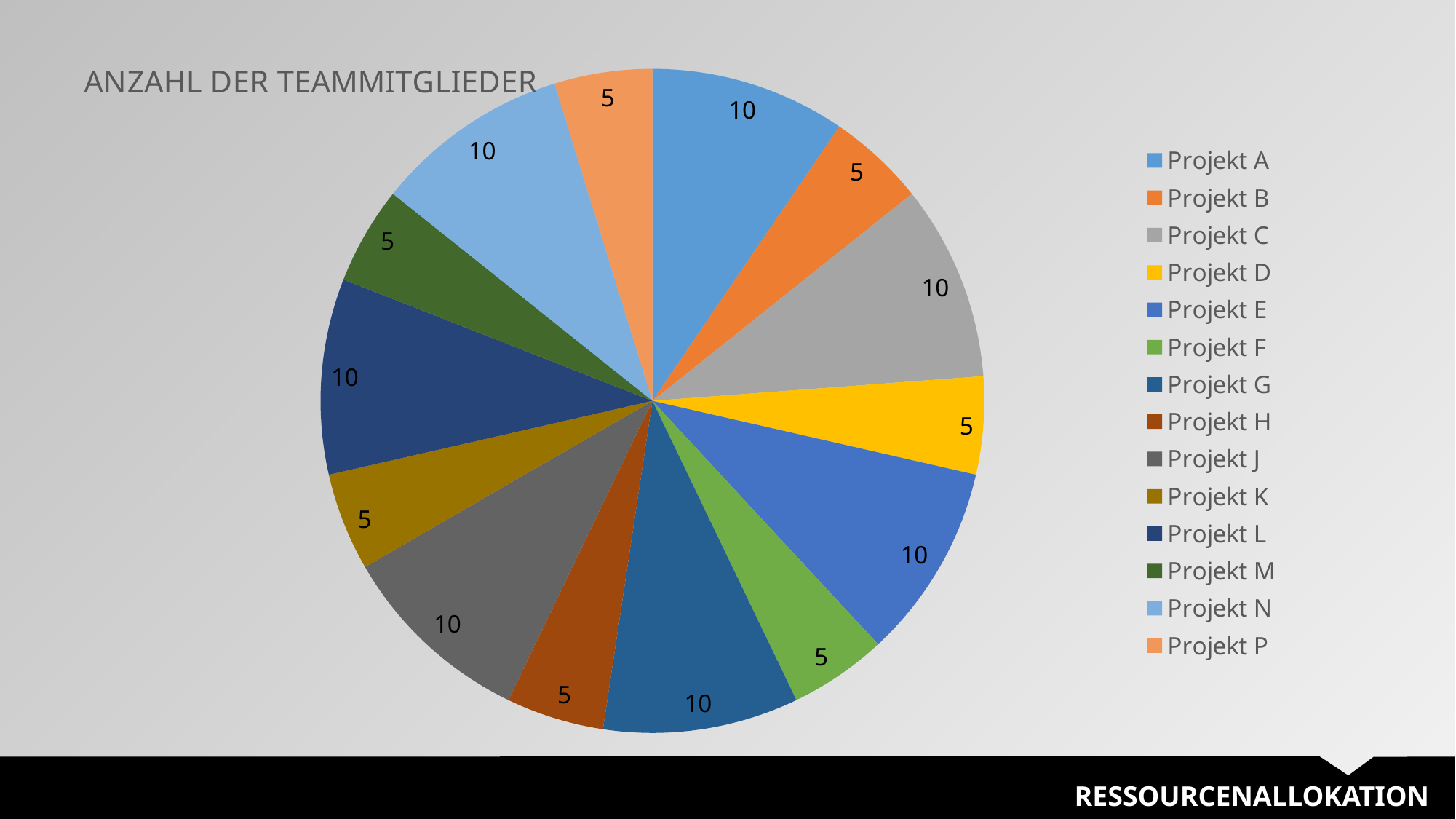
Which is larger, the value for Projekt C or the value for Projekt B? Projekt C What is the title of the chart? ANZAHL DER TEAMMITGLIEDER How many slices does the pie chart have? 14 What kind of chart is shown on the slide? pie chart What is the value for Projekt H? 5 What is the value for Projekt A? 10 What is the value for Projekt L? 10 How many entries does the legend list? 14 How many slices have the value 10? 7 What colour is the slice for Projekt D? yellow What is the value for Projekt D? 5 What is the difference between the value for Projekt E and the value for Projekt F? 5